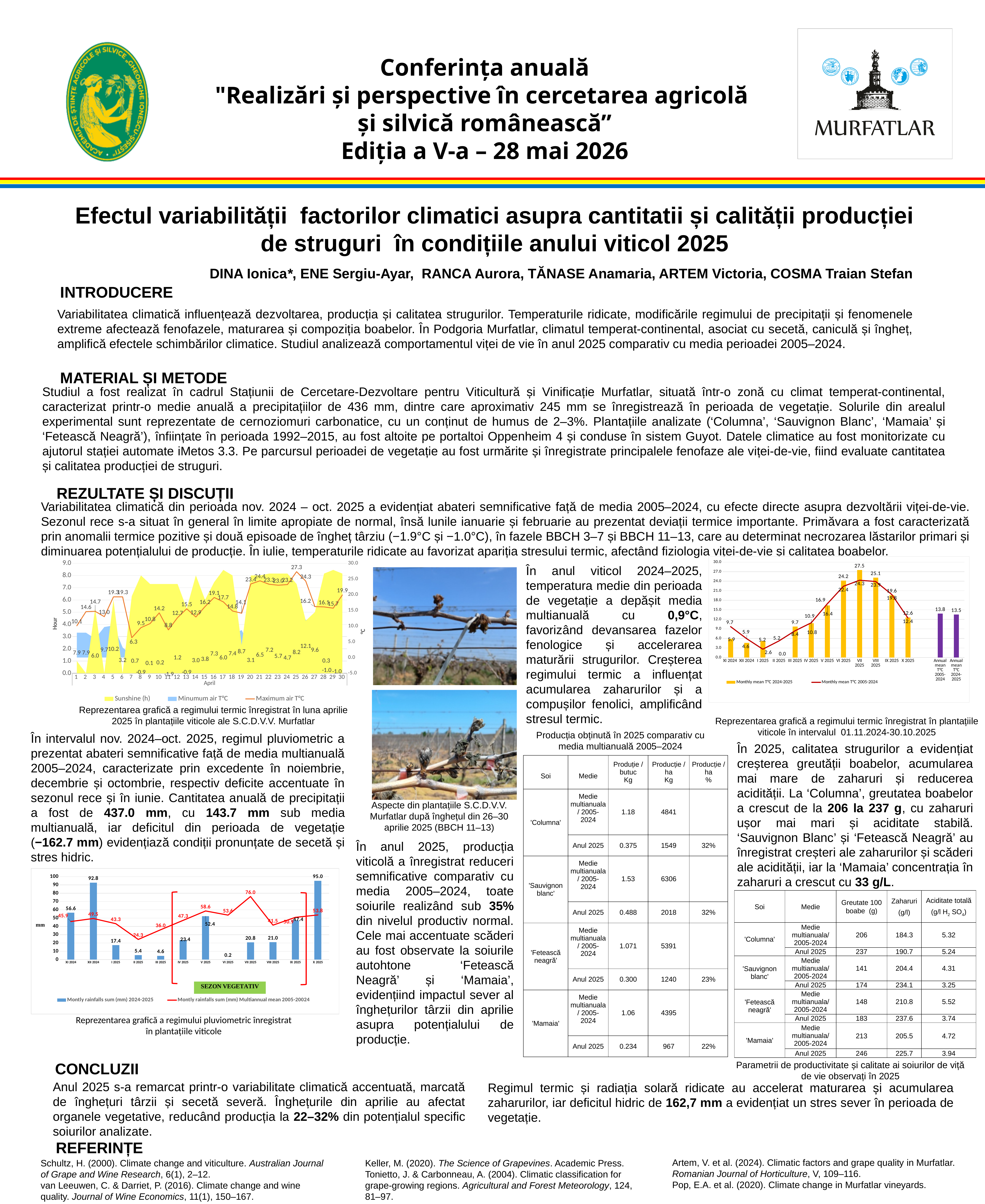
In the rainfall chart at the bottom left, what is the monthly rainfall sum (mm) for XII 2024? 92.8 In the April 2025 thermal regime chart on the left, how many series does the legend list? 3 In the monthly mean temperature chart on the right, which month has the highest monthly mean T°C for 2024-2025? VII 2025 In the rainfall chart at the bottom left, which month has the highest monthly rainfall sum for 2024-2025? X 2025 In the rainfall chart at the bottom left, what is the difference between the 2024-2025 rainfall sums for XII 2024 and XI 2024? 36.2 In the April 2025 thermal regime chart on the left, what is the highest maximum air temperature value shown? 27.3 In the rainfall chart at the bottom left, which month has the lowest monthly rainfall sum for 2024-2025? VI 2025 In the monthly mean temperature chart on the right, what is the monthly mean T°C 2024-2025 for VII 2025? 27.5 In the monthly mean temperature chart on the right, is the monthly mean T°C 2024-2025 for VI 2025 greater or less than the 2005-2024 mean for the same month? greater In the rainfall chart at the bottom left, what is the multiannual mean 2005-2024 rainfall value for VII 2025? 76.0 In the rainfall chart at the bottom left, how many series does the legend list? 2 In the monthly mean temperature chart on the right, what is the monthly mean T°C 2024-2025 for II 2025? 0.0